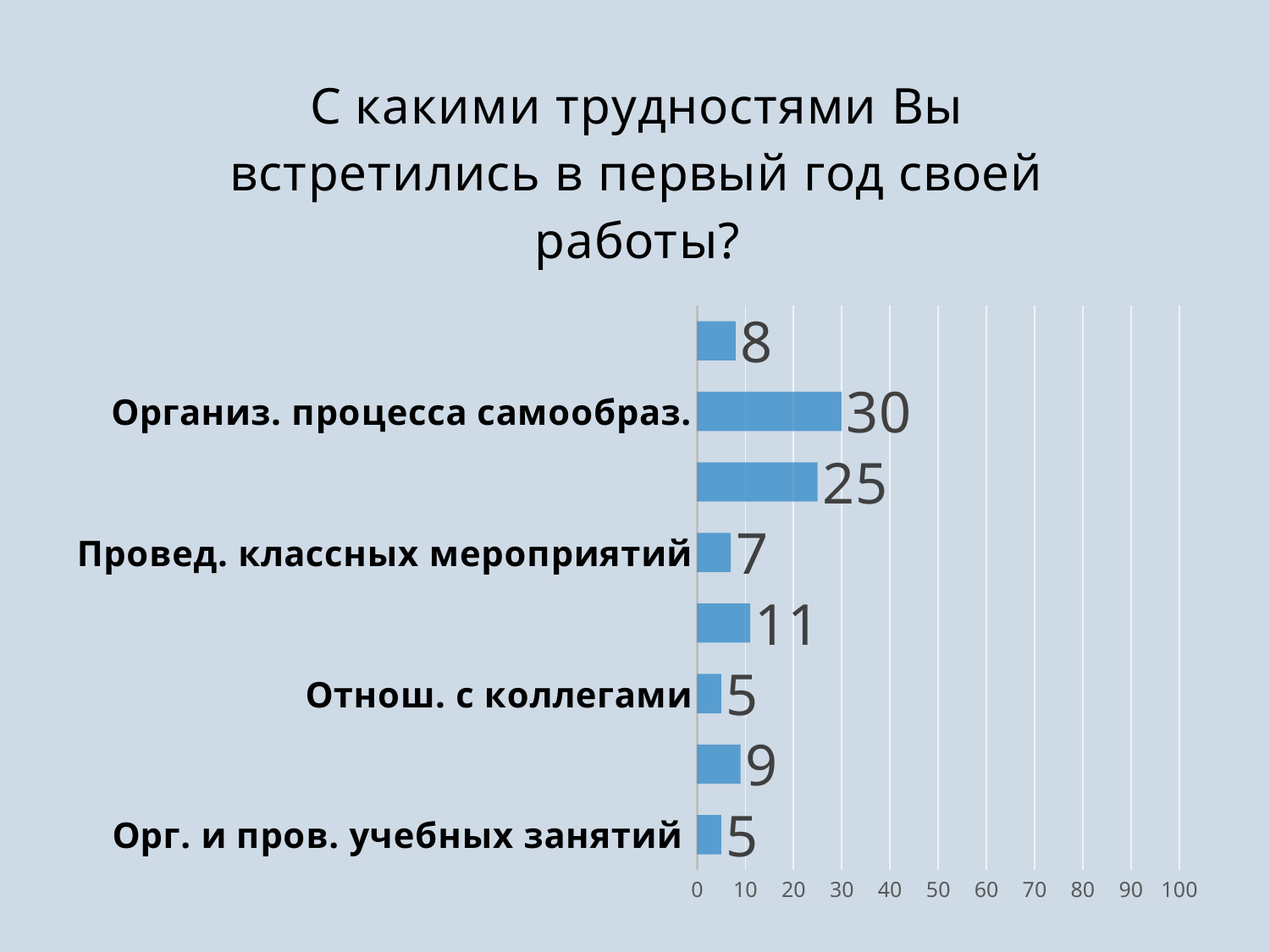
What is the value for "Провед. классных мероприятий"? 7 What is the value for "Организ. процесса самообраз."? 30 Which is larger: the value for "Провед. классных мероприятий" or the value for "Отнош. с коллегами"? Провед. классных мероприятий What is the maximum value shown on the horizontal axis of the chart? 100 Is the value for "Организ. процесса самообраз." greater or less than 20? greater What type of chart is shown on the slide? bar chart Which category has the highest value in the chart? Организ. процесса самообраз. What is the value for "Отнош. с коллегами"? 5 What is the value for "Орг. и пров. учебных занятий"? 5 How many bars are plotted in the chart? 8 What is the difference between the values for "Организ. процесса самообраз." and "Провед. классных мероприятий"? 23 What is the highest value shown in the chart? 30